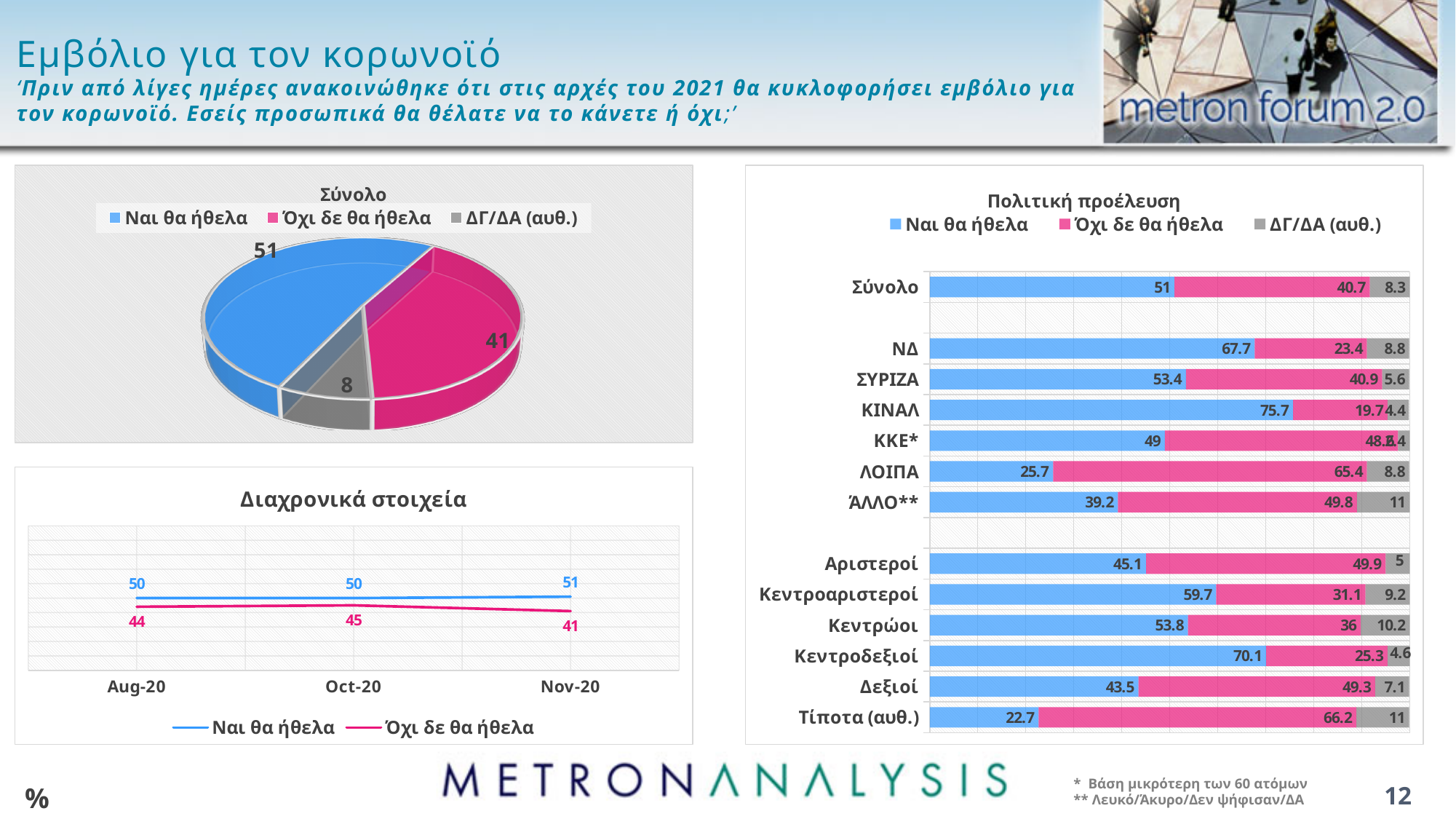
In the chart titled Πολιτική προέλευση, which category has the highest value for Ναι θα ήθελα? ΚΙΝΑΛ In the chart titled Διαχρονικά στοιχεία, what is the value for Όχι δε θα ήθελα at Oct-20? 45 In the chart titled Πολιτική προέλευση, what is the difference between the Ναι θα ήθελα values for ΝΔ and ΣΥΡΙΖΑ? 14.3 In the pie chart titled Σύνολο, what is the value for Ναι θα ήθελα? 51 In the chart titled Διαχρονικά στοιχεία, how many series does the legend list? 2 What kind of chart is the chart titled Σύνολο? pie chart In the chart titled Πολιτική προέλευση, which category has the lowest value for Ναι θα ήθελα? Τίποτα (αυθ.) In the chart titled Πολιτική προέλευση, what is the value of Ναι θα ήθελα for ΝΔ? 67.7 In the chart titled Πολιτική προέλευση, which has the larger ΔΓ/ΔΑ (αυθ.) value, Κεντρώοι or Κεντροδεξιοί? Κεντρώοι In the pie chart titled Σύνολο, what share of the pie does Όχι δε θα ήθελα represent? 41% In the chart titled Διαχρονικά στοιχεία, what is the difference between Ναι θα ήθελα and Όχι δε θα ήθελα at Nov-20? 10 In the chart titled Διαχρονικά στοιχεία, how many time points are shown on the x axis? 3